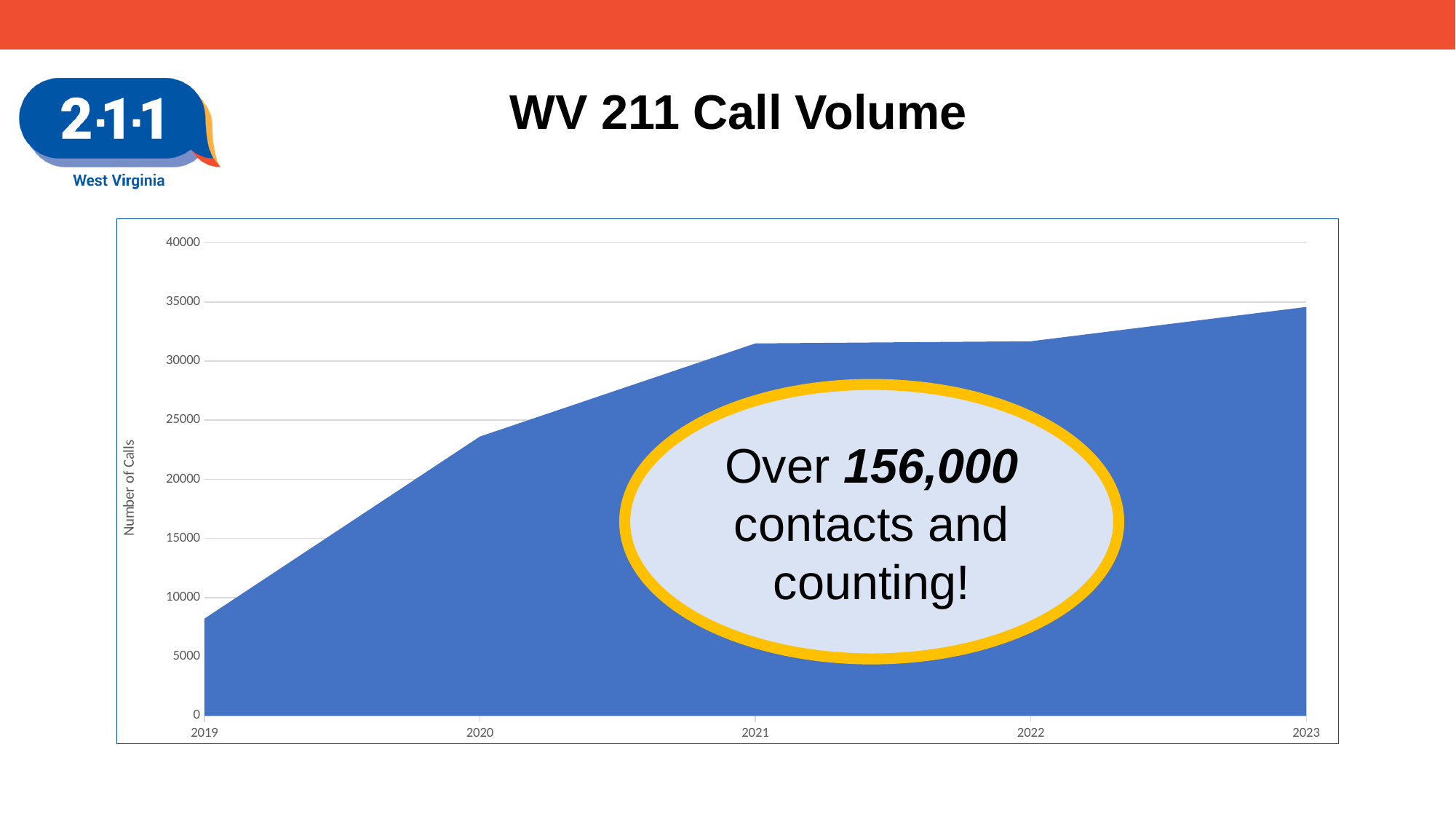
What kind of chart is shown on the slide? area chart Which year has the larger call volume, 2020 or 2021? 2021 Is the call volume for 2019 greater or less than 10000? less Does the call volume generally rise or fall from 2019 to 2023? rise Is the call volume for 2020 greater or less than 25000? less How many years are plotted along the x axis of the chart? 5 Which year has the highest call volume in the chart? 2023 What is the label on the vertical axis of the chart? Number of Calls Which year has the lowest call volume in the chart? 2019 Is the call volume for 2021 greater or less than 30000? greater